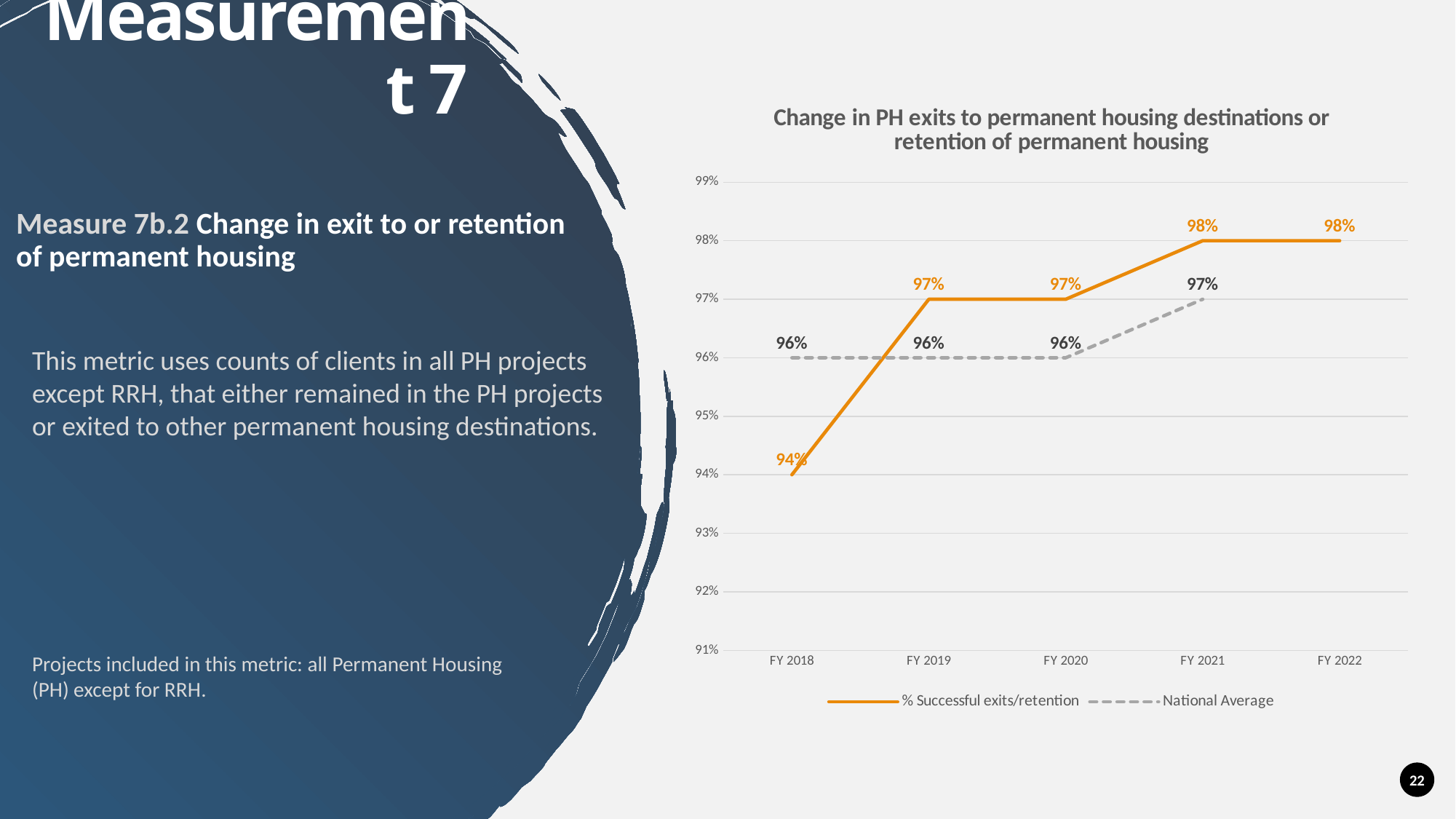
What kind of chart is shown on the slide? Line chart How many series does the legend list? 2 In FY 2018, which series has the higher value: % Successful exits/retention or National Average? National Average What is the difference between the % Successful exits/retention value in FY 2022 and in FY 2018? 4% In which fiscal year is the % Successful exits/retention value lowest? FY 2018 How many fiscal years are shown on the x axis? 5 What is the National Average value for FY 2021? 97% What is the % Successful exits/retention value for FY 2022? 98% Does the % Successful exits/retention series rise or fall from FY 2018 to FY 2022? Rise What is the title of the chart? Change in PH exits to permanent housing destinations or retention of permanent housing What is the % Successful exits/retention value for FY 2018? 94% In FY 2019, which series has the higher value: % Successful exits/retention or National Average? % Successful exits/retention